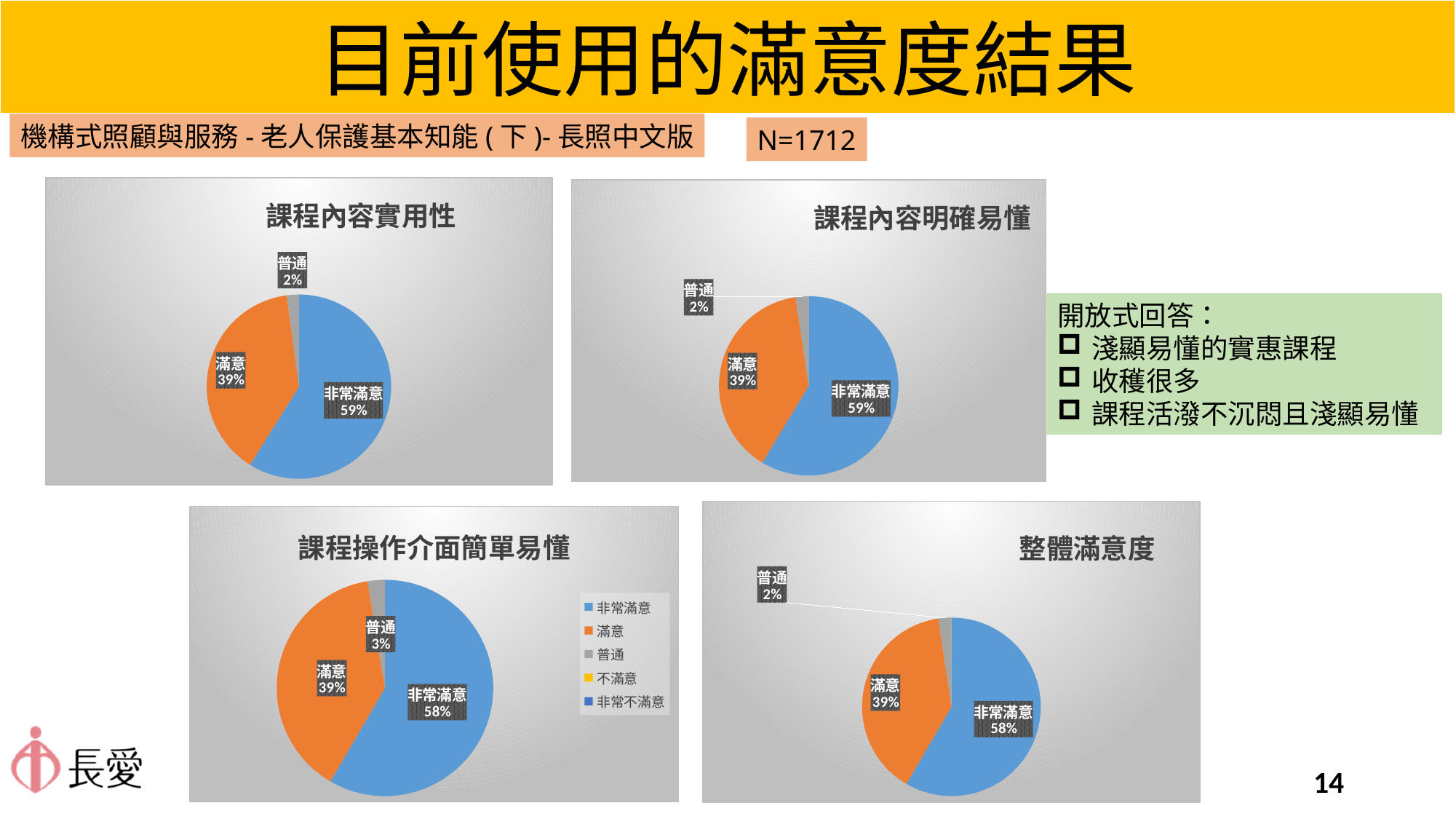
In the 課程內容實用性 chart, which category has the smallest slice? 普通 In the 課程內容實用性 chart, what share of respondents answered 非常滿意? 59% In the 課程操作介面簡單易懂 chart, what percentage is shown for 普通? 3% In the 課程內容明確易懂 chart, what percentage is shown for 滿意? 39% In the 整體滿意度 chart, how many slices have data labels? 3 How many charts are shown on the slide? 4 In the 整體滿意度 chart, what share of respondents answered 非常滿意? 58% In the 課程操作介面簡單易懂 chart, which is larger, 非常滿意 or 滿意? 非常滿意 In the 課程內容明確易懂 chart, which category has the largest slice? 非常滿意 What kind of chart is the 整體滿意度 chart? Pie chart In the 課程操作介面簡單易懂 chart, how many entries does the legend list? 5 In the 課程內容明確易懂 chart, what is the difference between the 非常滿意 and 滿意 shares? 20%